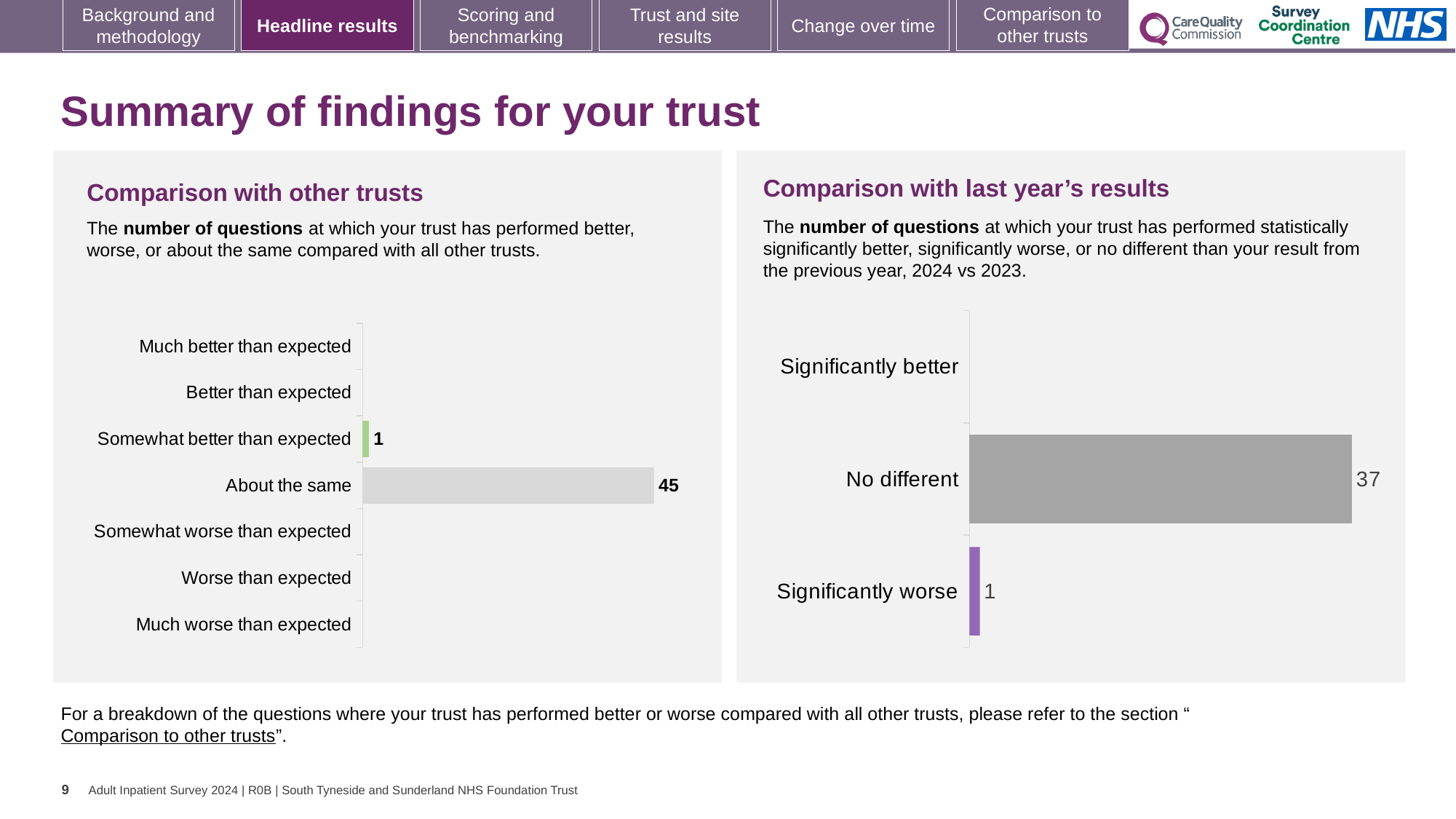
What kind of chart is the 'Comparison with other trusts' chart? Bar chart In the 'Comparison with last year's results' chart, how many categories are listed on the axis? 3 In the 'Comparison with last year's results' chart, what is the difference between 'No different' and 'Significantly worse'? 36 In the 'Comparison with other trusts' chart, how many categories are listed on the axis? 7 In the 'Comparison with other trusts' chart, what is the value for 'About the same'? 45 In the 'Comparison with other trusts' chart, what is the value for 'Somewhat better than expected'? 1 In the 'Comparison with last year's results' chart, which category has the highest value? No different In the 'Comparison with last year's results' chart, what is the value for 'Significantly worse'? 1 In the 'Comparison with last year's results' chart, what is the value for 'No different'? 37 In the 'Comparison with other trusts' chart, what is the difference between 'About the same' and 'Somewhat better than expected'? 44 In the 'Comparison with other trusts' chart, which category has the highest value? About the same In the 'Comparison with last year's results' chart, what colour is the 'Significantly worse' bar? Purple